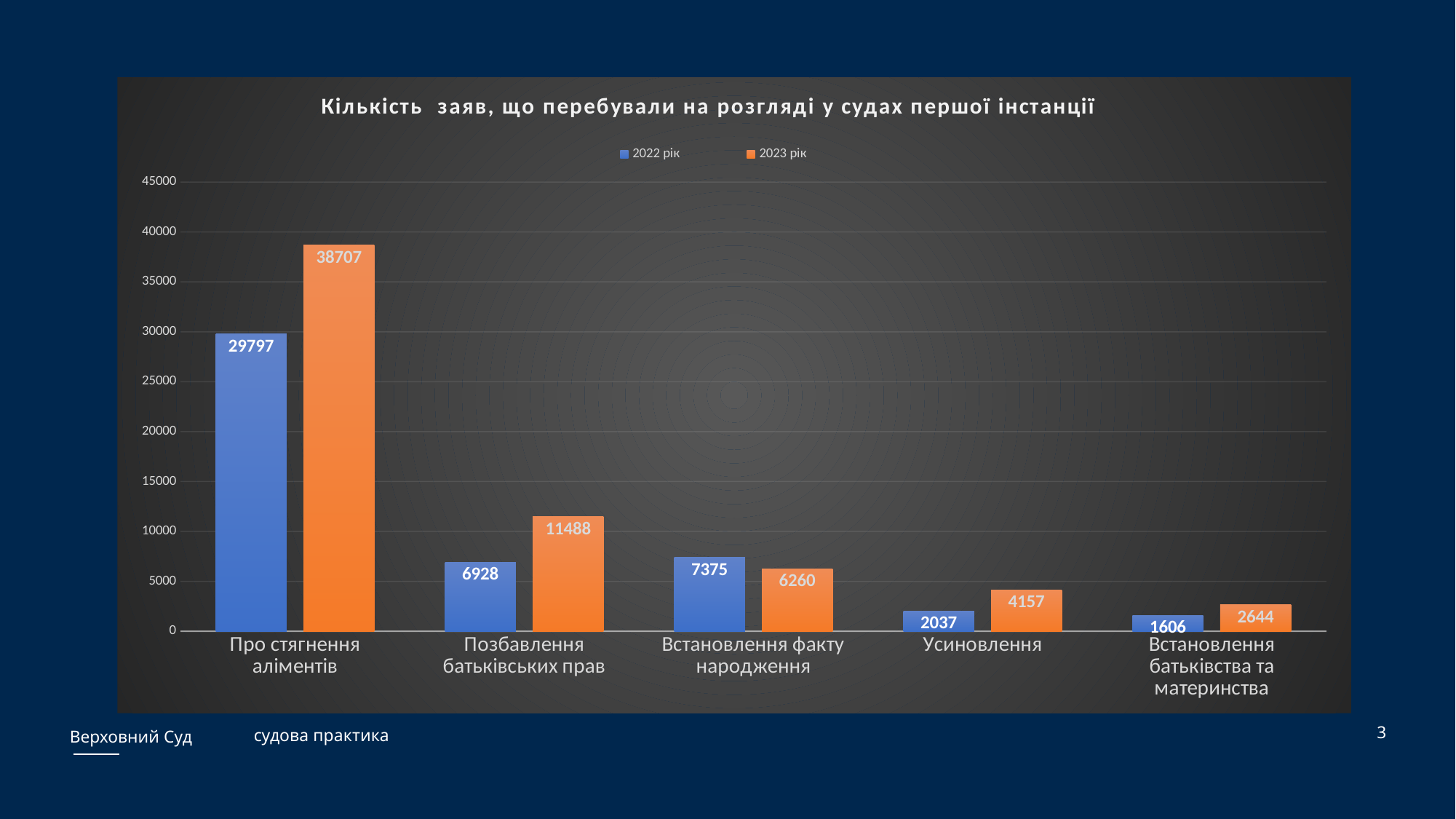
What is the value for 2022 рік for Усиновлення? 2037 What is the value for 2022 рік for Про стягнення аліментів? 29797 Which category has the highest value for 2023 рік? Про стягнення аліментів How many series does the legend list? 2 What type of chart is shown on the slide? bar chart What is the difference between the 2023 рік and 2022 рік values for Про стягнення аліментів? 8910 Which category has the lowest value for 2022 рік? Встановлення батьківства та материнства For Встановлення факту народження, which year has the larger value, 2022 рік or 2023 рік? 2022 рік What is the value for 2023 рік for Встановлення батьківства та материнства? 2644 What is the value for 2023 рік for Позбавлення батьківських прав? 11488 How many categories are shown on the x axis? 5 Is the value for 2023 рік for Усиновлення greater or less than 5000? less